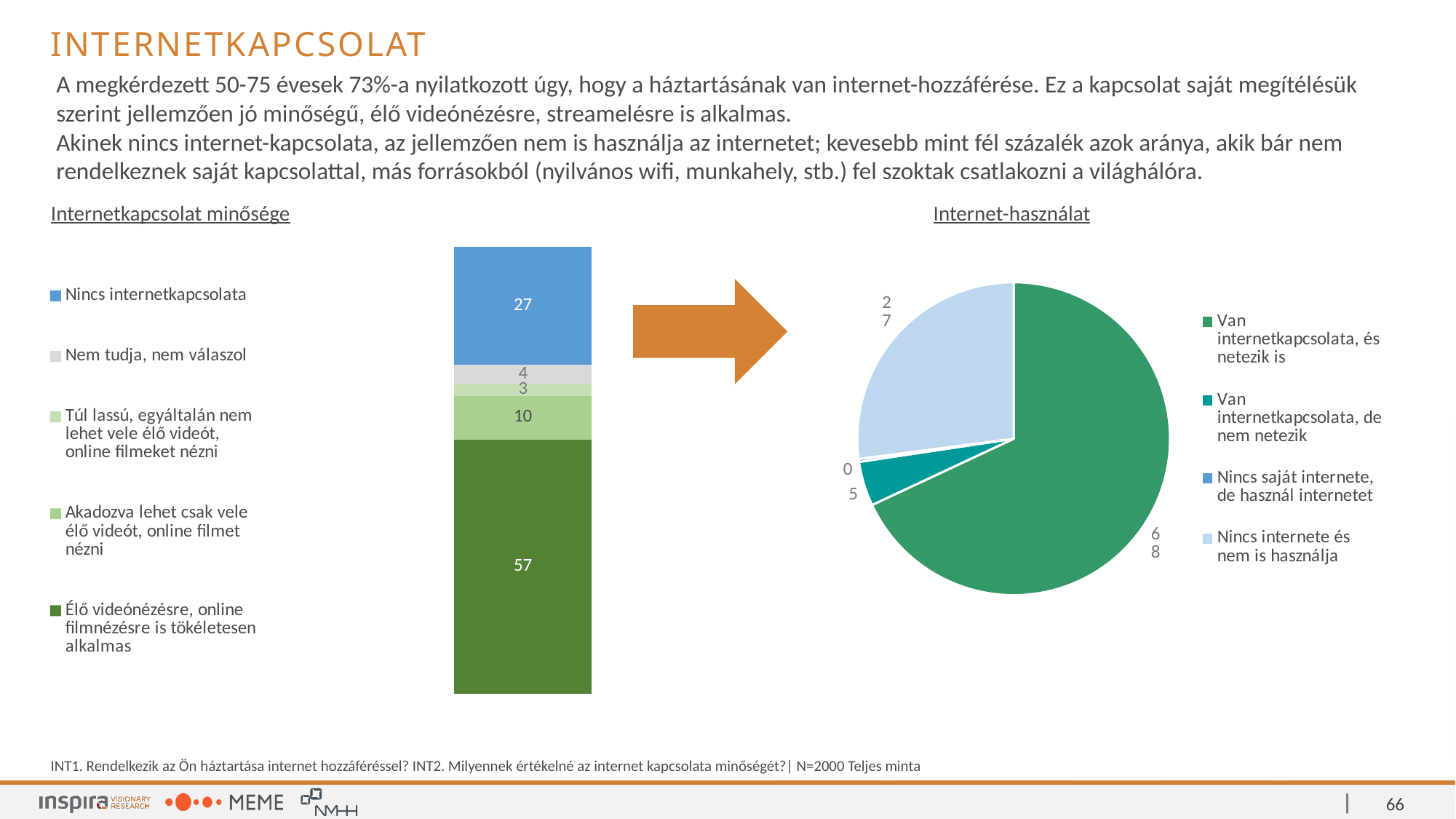
In the 'Internet-használat' chart, what is the value for 'Van internetkapcsolata, de nem netezik'? 5 In the 'Internetkapcsolat minősége' chart, what is the difference between the 'Élő videónézésre, online filmnézésre is tökéletesen alkalmas' value and the 'Nincs internetkapcsolata' value? 30 In the 'Internetkapcsolat minősége' chart, how many segments does the legend list? 5 In the 'Internet-használat' chart, which category has the smallest value? Nincs saját internete, de használ internetet What kind of chart is the 'Internet-használat' chart? Pie chart In the 'Internetkapcsolat minősége' chart, which segment has the smallest value? Túl lassú, egyáltalán nem lehet vele élő videót, online filmeket nézni What kind of chart is the 'Internetkapcsolat minősége' chart? Stacked bar chart In the 'Internet-használat' chart, what is the value for 'Van internetkapcsolata, és netezik is'? 68 In the 'Internetkapcsolat minősége' chart, what is the value for 'Nincs internetkapcsolata'? 27 In the 'Internetkapcsolat minősége' chart, what is the value for 'Élő videónézésre, online filmnézésre is tökéletesen alkalmas'? 57 In the 'Internetkapcsolat minősége' chart, what is the value for 'Akadozva lehet csak vele élő videót, online filmet nézni'? 10 In the 'Internetkapcsolat minősége' chart, which segment has the largest value? Élő videónézésre, online filmnézésre is tökéletesen alkalmas